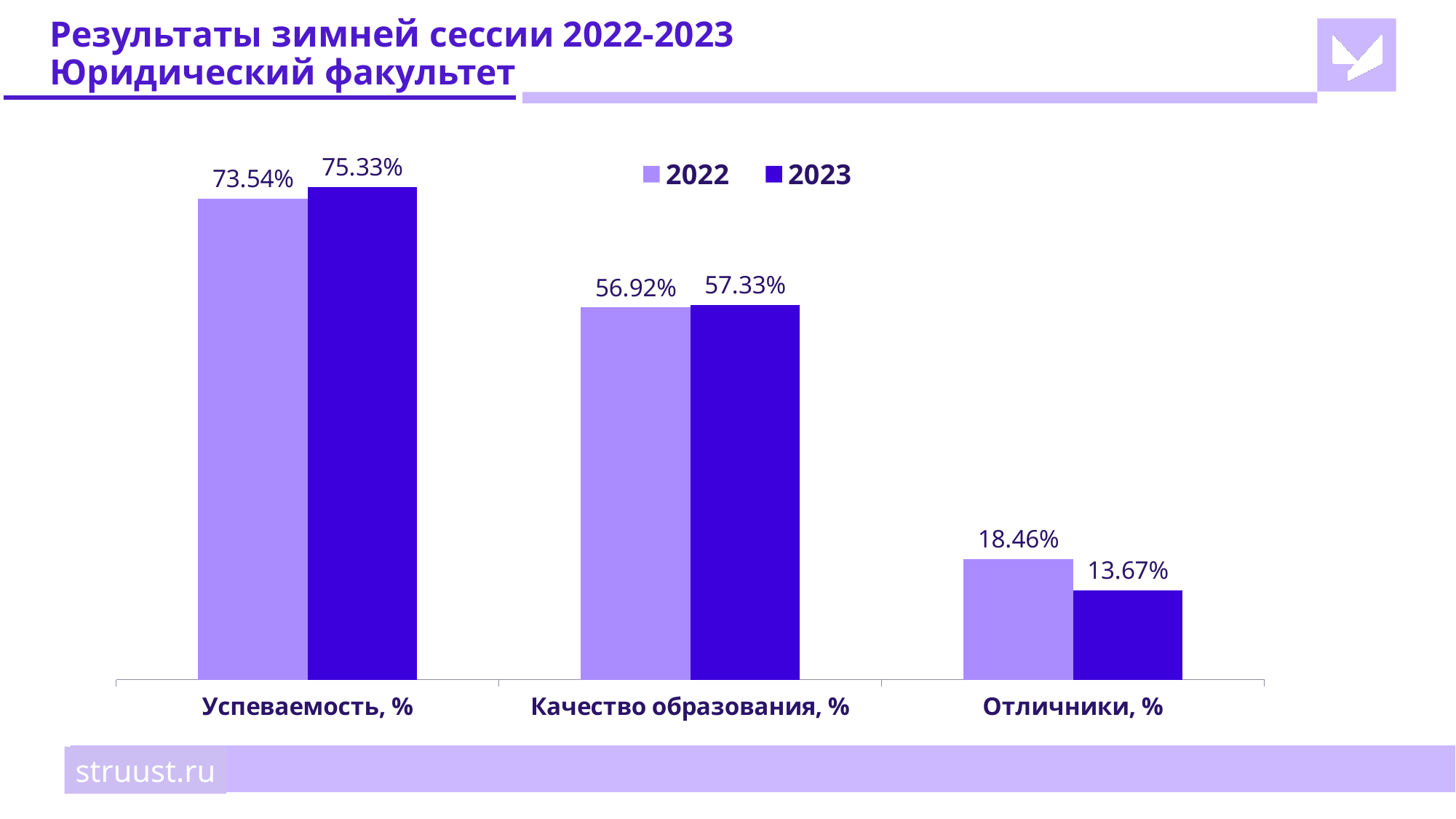
For Отличники, %, which year has the larger value, 2022 or 2023? 2022 What is the difference between the 2023 and 2022 values for Успеваемость, %? 1.79% Which category has the highest value in the 2023 series? Успеваемость, % What is the difference between the 2022 and 2023 values for Отличники, %? 4.79% What is the value for Успеваемость, % in 2023? 75.33% How many categories are shown on the x axis? 3 What is the value for Успеваемость, % in 2022? 73.54% How many series does the legend list? 2 What kind of chart is shown on the slide? Bar chart What is the value for Отличники, % in 2022? 18.46% What is the value for Качество образования, % in 2023? 57.33% Which category has the lowest value in the 2022 series? Отличники, %